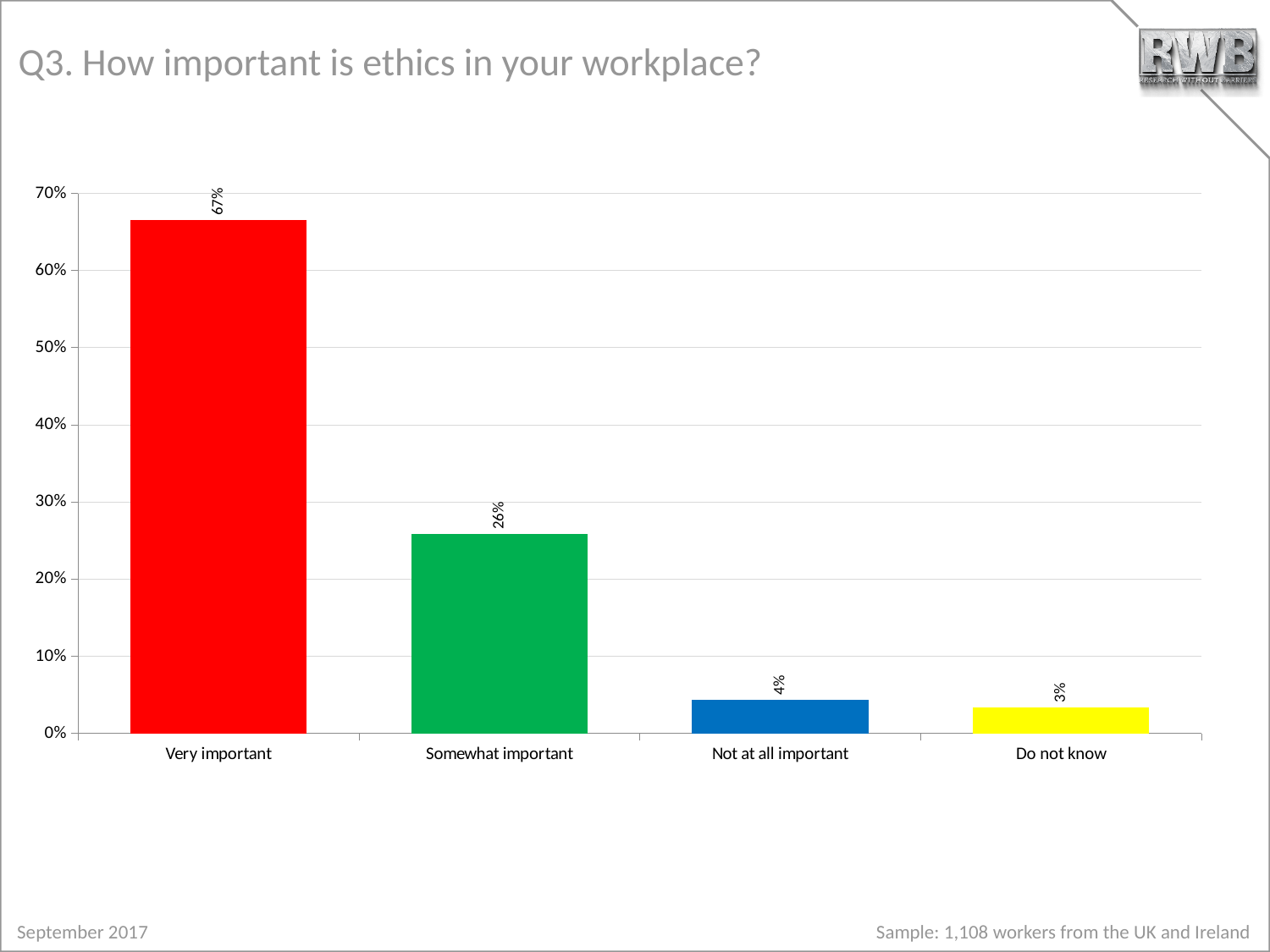
What kind of chart is shown on the slide? Bar chart What is the value for Not at all important? 4% Which category has the lowest value? Do not know What is the difference between the values for Very important and Somewhat important? 41 percentage points How many categories are shown on the x axis? 4 What colour is the bar for Somewhat important? Green What is the value for Somewhat important? 26% Is the value for Somewhat important greater or less than 30%? less Which category has the highest value? Very important What is the value for Do not know? 3% Which is larger, the value for Not at all important or the value for Do not know? Not at all important What percentage of respondents said ethics is very important in their workplace? 67%